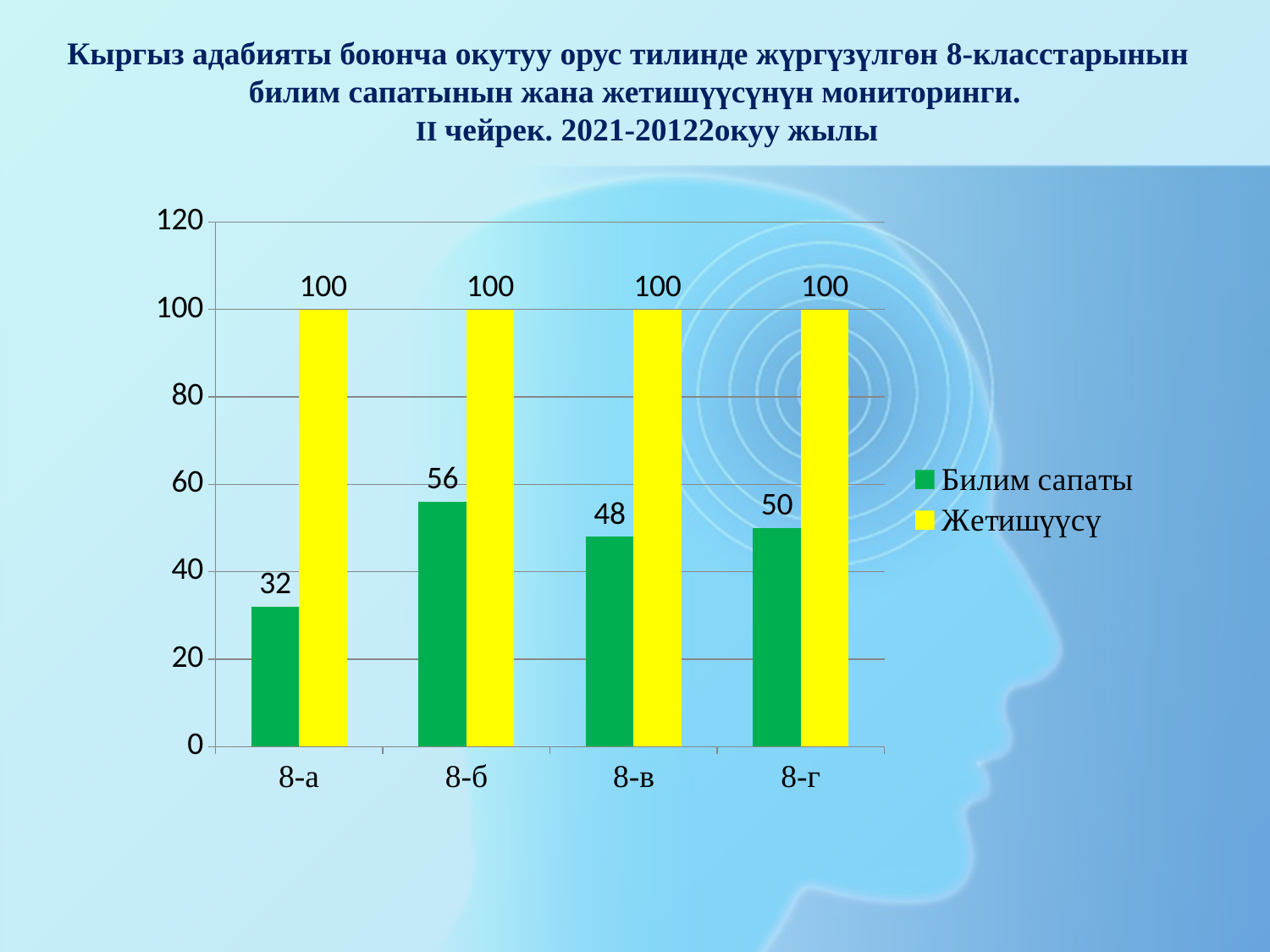
How many classes are shown on the x axis? 4 What kind of chart is shown on the slide? bar chart What colour are the Жетишүүсү bars? yellow What is the difference between the Билим сапаты values for 8-б and 8-а? 24 What is the value of Жетишүүсү for 8-в? 100 What is the value of Билим сапаты for 8-б? 56 How many series does the legend list? 2 What is the value of Билим сапаты for 8-а? 32 Which is larger, the Билим сапаты value for 8-в or for 8-г? 8-г Which class has the lowest Билим сапаты value? 8-а Which class has the highest Билим сапаты value? 8-б Is the Билим сапаты value for 8-а greater or less than 40? less